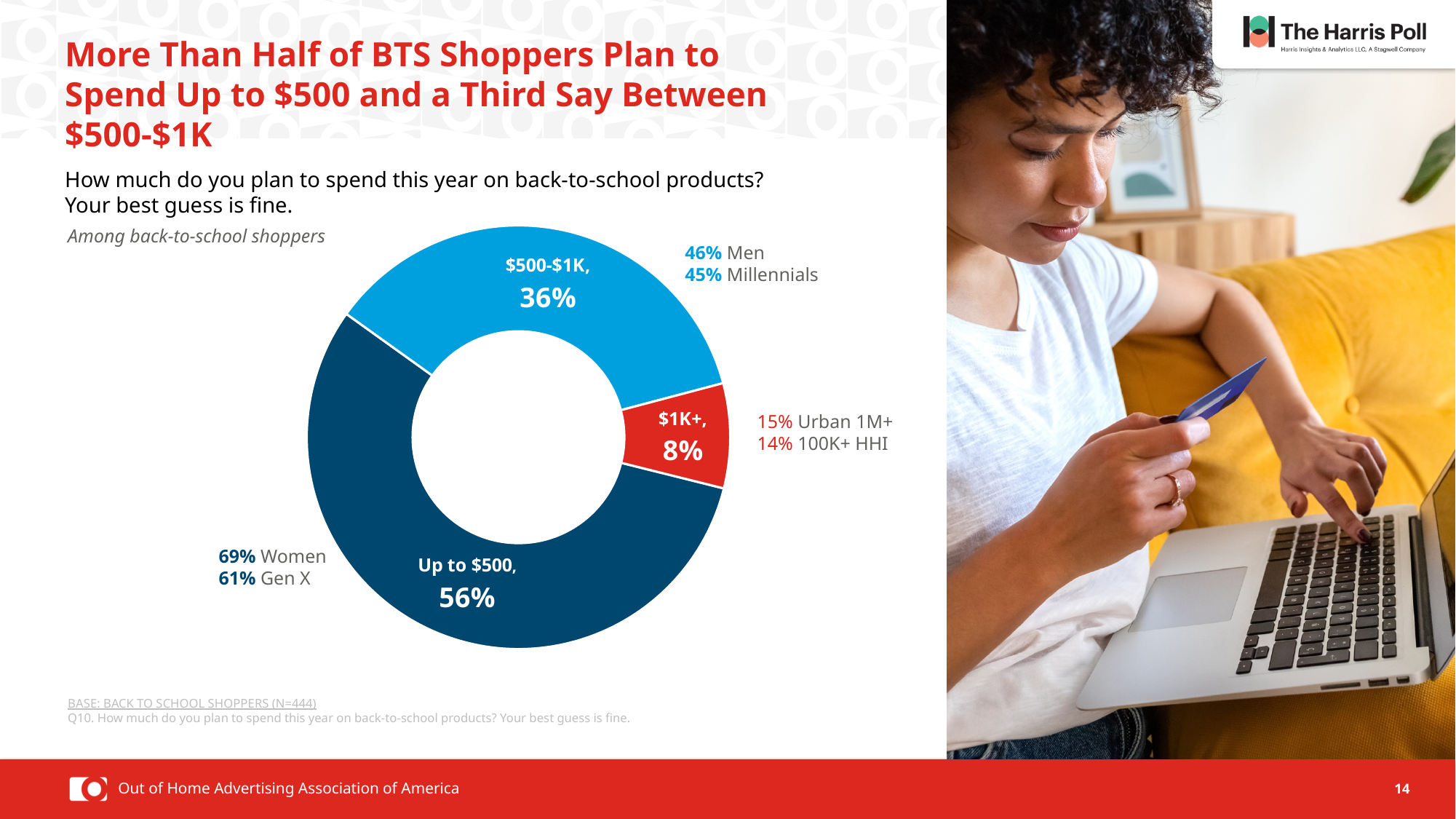
Which spending category has the largest share of the pie? Up to $500 What is the difference in percentage points between the 'Up to $500' and '$500-$1K' slices? 20 What percentage of Millennials plan to spend $500-$1K, according to the annotation next to that slice? 45% What percentage of back-to-school shoppers plan to spend $500-$1K? 36% What kind of chart is shown on the slide? Pie chart (donut) What colour is the '$1K+' slice of the chart? Red What percentage of Women plan to spend up to $500, according to the annotation next to that slice? 69% Which spending category has the smallest share of the pie? $1K+ What percentage of back-to-school shoppers plan to spend up to $500? 56% How many spending categories are shown in the chart? 3 What percentage of back-to-school shoppers plan to spend $1K+? 8% Which slice is larger: '$500-$1K' or '$1K+'? $500-$1K